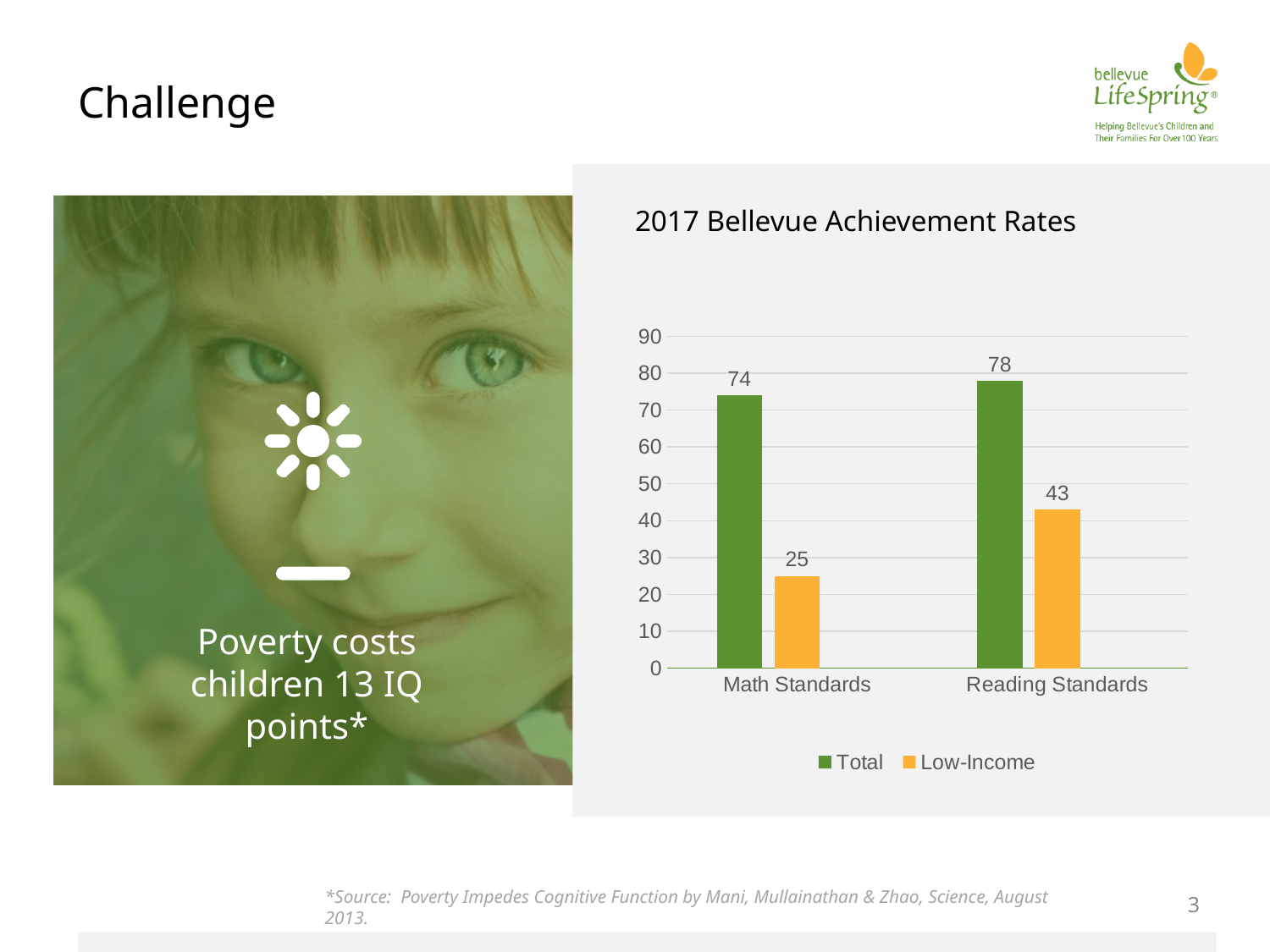
What kind of chart is shown on the slide? Bar chart What is the Low-Income value for Math Standards? 25 What is the Total value for Math Standards? 74 How many series does the legend list? 2 Which category has the lowest Low-Income value? Math Standards What is the difference between the Total and Low-Income values for Math Standards? 49 What is the Low-Income value for Reading Standards? 43 How many categories are shown on the x axis? 2 Which category has the highest Total value? Reading Standards What is the title of the chart? 2017 Bellevue Achievement Rates Which is larger, the Low-Income value for Reading Standards or the Low-Income value for Math Standards? Reading Standards What is the difference between the Total and Low-Income values for Reading Standards? 35